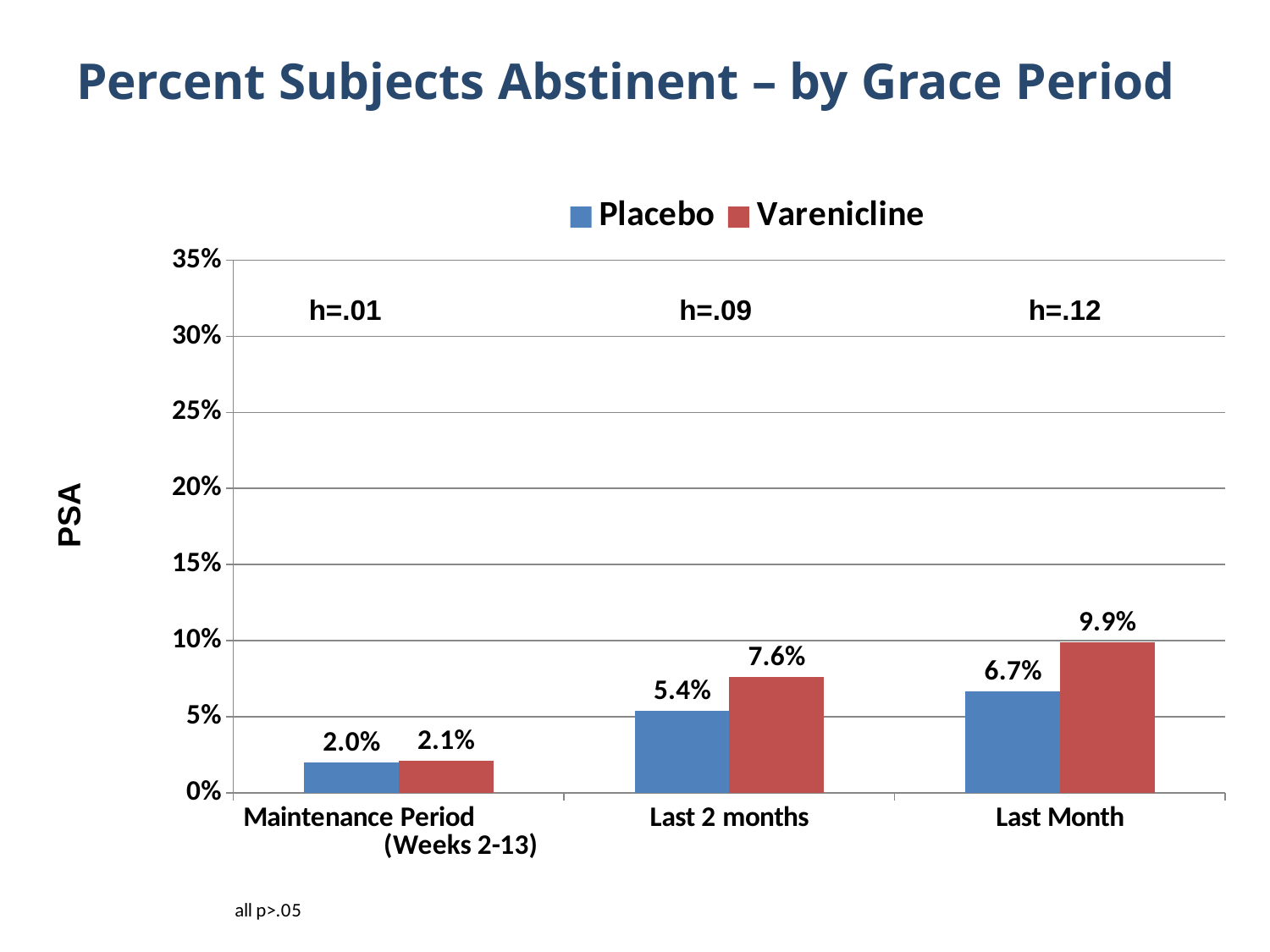
Which category has the lowest Placebo value? Maintenance Period (Weeks 2-13) Do the Placebo values rise or fall from Maintenance Period to Last Month? Rise What is the difference between the Varenicline and Placebo values for Last Month? 3.2% How many categories are shown on the x axis? 3 What is the Placebo value for Last Month? 6.7% What kind of chart is shown? Bar chart What is the Placebo value for Last 2 months? 5.4% What is the Varenicline value for Last Month? 9.9% Which is larger for Last 2 months, Placebo or Varenicline? Varenicline Which category has the highest Varenicline value? Last Month How many series does the legend list? 2 What is the Varenicline value for Maintenance Period (Weeks 2-13)? 2.1%